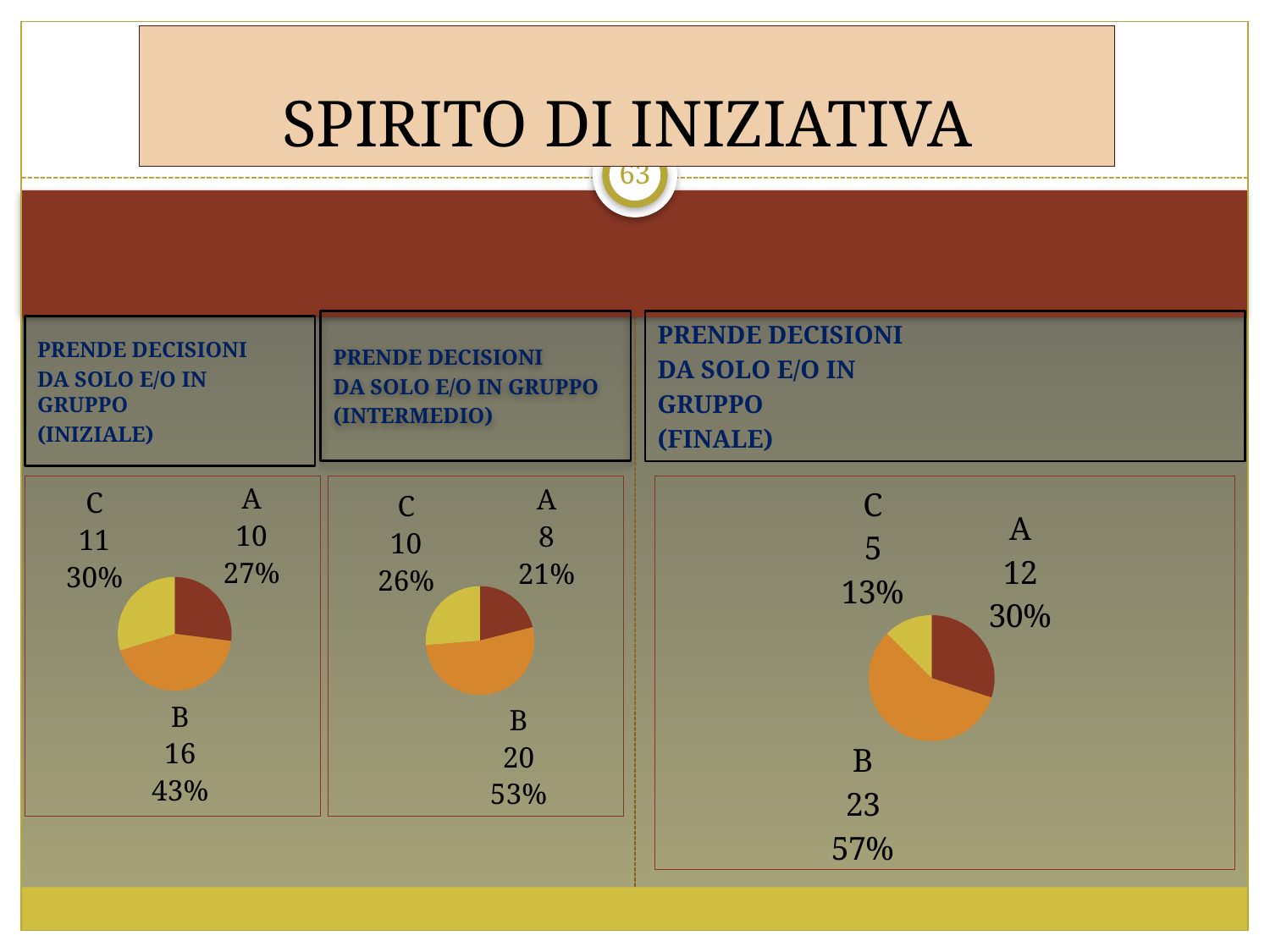
What kind of chart is used in the INTERMEDIO panel? Pie chart In the FINALE pie chart, which category has the smallest slice? C How many slices does the FINALE pie chart have? 3 In the INIZIALE pie chart, what share of the pie does category C represent? 30% In the INTERMEDIO pie chart, which category has the largest slice? B In the FINALE pie chart, what is the value for category C? 5 In the INIZIALE pie chart, what is the value for category B? 16 In the INTERMEDIO pie chart, what share of the pie does category B represent? 53% In the INIZIALE pie chart, which is larger, the value for A or the value for C? C In the INTERMEDIO pie chart, what is the value for category A? 8 In the FINALE pie chart, what is the difference between the values for B and A? 11 How many pie charts are shown on the slide? 3